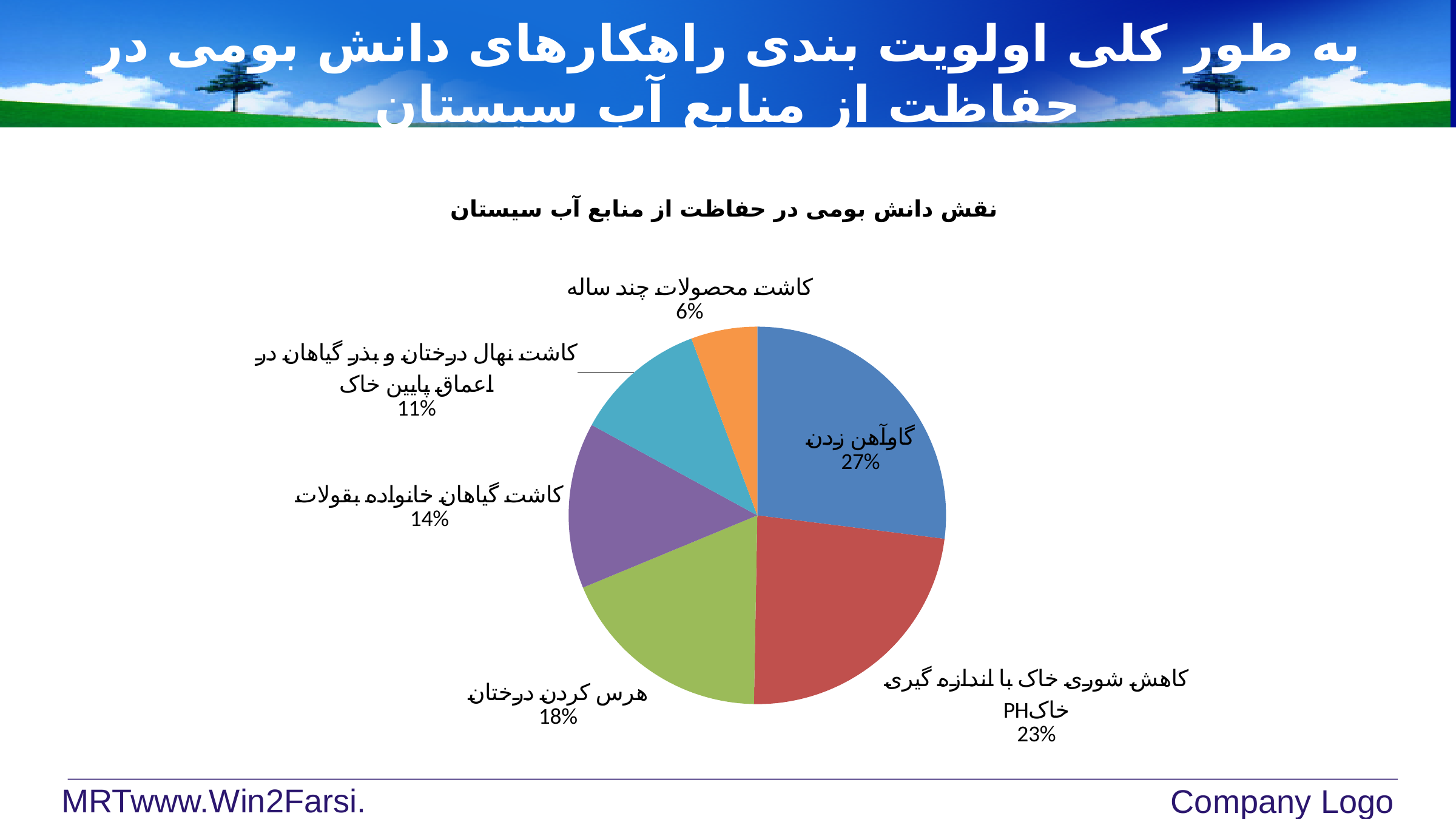
Which category has the smallest share of the pie? کاشت محصولات چند ساله What kind of chart is shown on the slide? pie chart What percentage is shown for کاشت محصولات چند ساله? 6% What share of the pie is labelled گاوآهن زدن? 27% What percentage is shown for کاشت گیاهان خانواده بقولات? 14% Which is larger: the share for کاشت نهال درختان و بذر گیاهان در اعماق پایین خاک or the share for کاشت محصولات چند ساله? کاشت نهال درختان و بذر گیاهان در اعماق پایین خاک What is the title of the chart? نقش دانش بومی در حفاظت از منابع آب سیستان What is the difference in percentage points between هرس کردن درختان and کاشت گیاهان خانواده بقولات? 4 What percentage is shown for هرس کردن درختان? 18% What percentage is shown for کاهش شوری خاک با اندازه گیری PH خاک? 23% Which category has the largest share of the pie? گاوآهن زدن How many slices does the pie chart have? 6